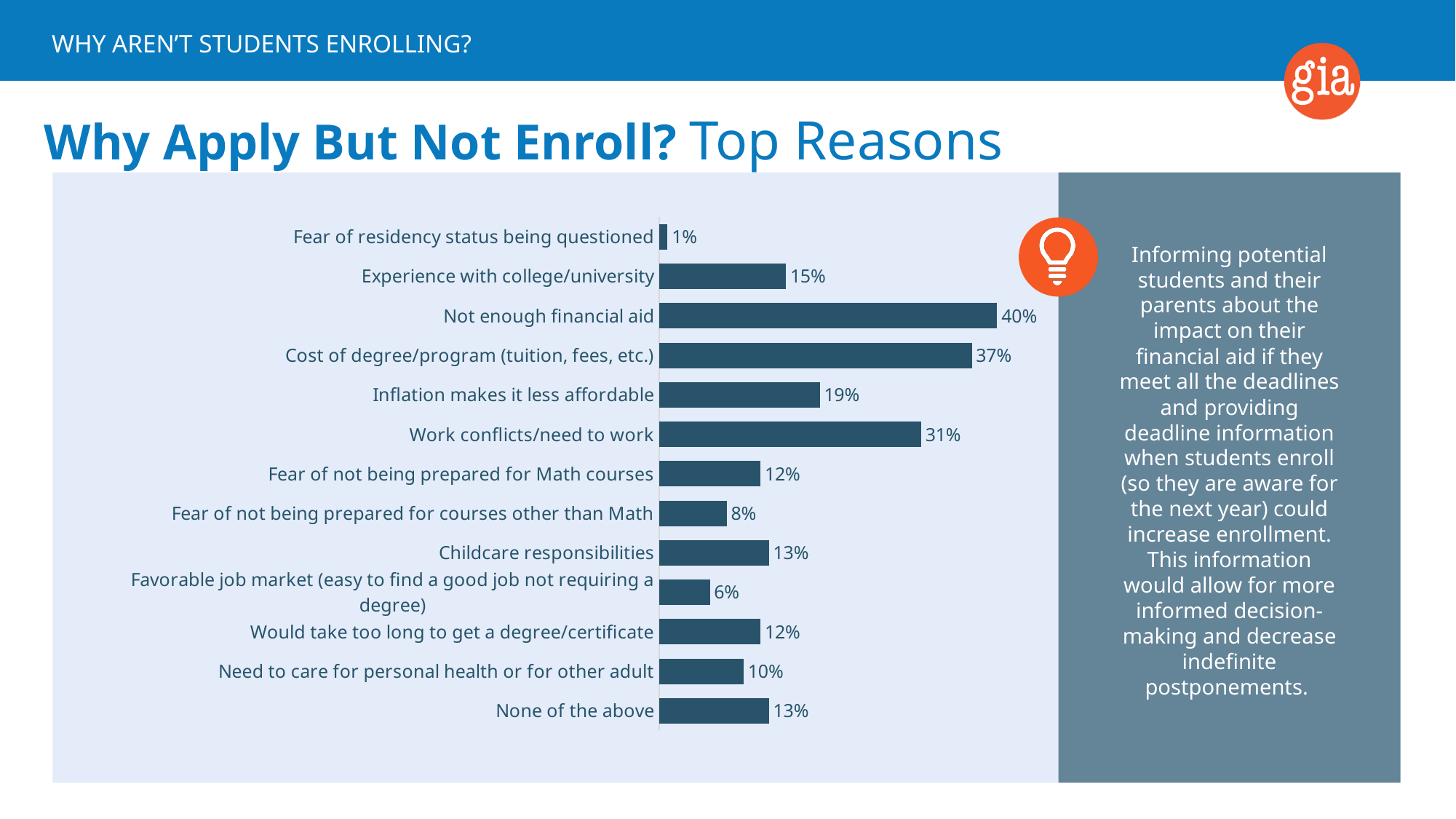
What kind of chart is shown on the slide? Bar chart What is the value for "Inflation makes it less affordable"? 19% What percentage of respondents cited "Not enough financial aid" as a reason? 40% Which reason has the highest percentage? Not enough financial aid What is the difference between "Work conflicts/need to work" and "Need to care for personal health or for other adult"? 21% What is the value for "Work conflicts/need to work"? 31% How many reasons (categories) are listed in the chart? 13 What percentage is shown for "Fear of residency status being questioned"? 1% Which reason has the lowest percentage? Fear of residency status being questioned Which is larger: "Experience with college/university" or "Childcare responsibilities"? Experience with college/university What is the title of the slide containing the chart? Why Apply But Not Enroll? Top Reasons What is the difference between "Not enough financial aid" and "Cost of degree/program (tuition, fees, etc.)"? 3%